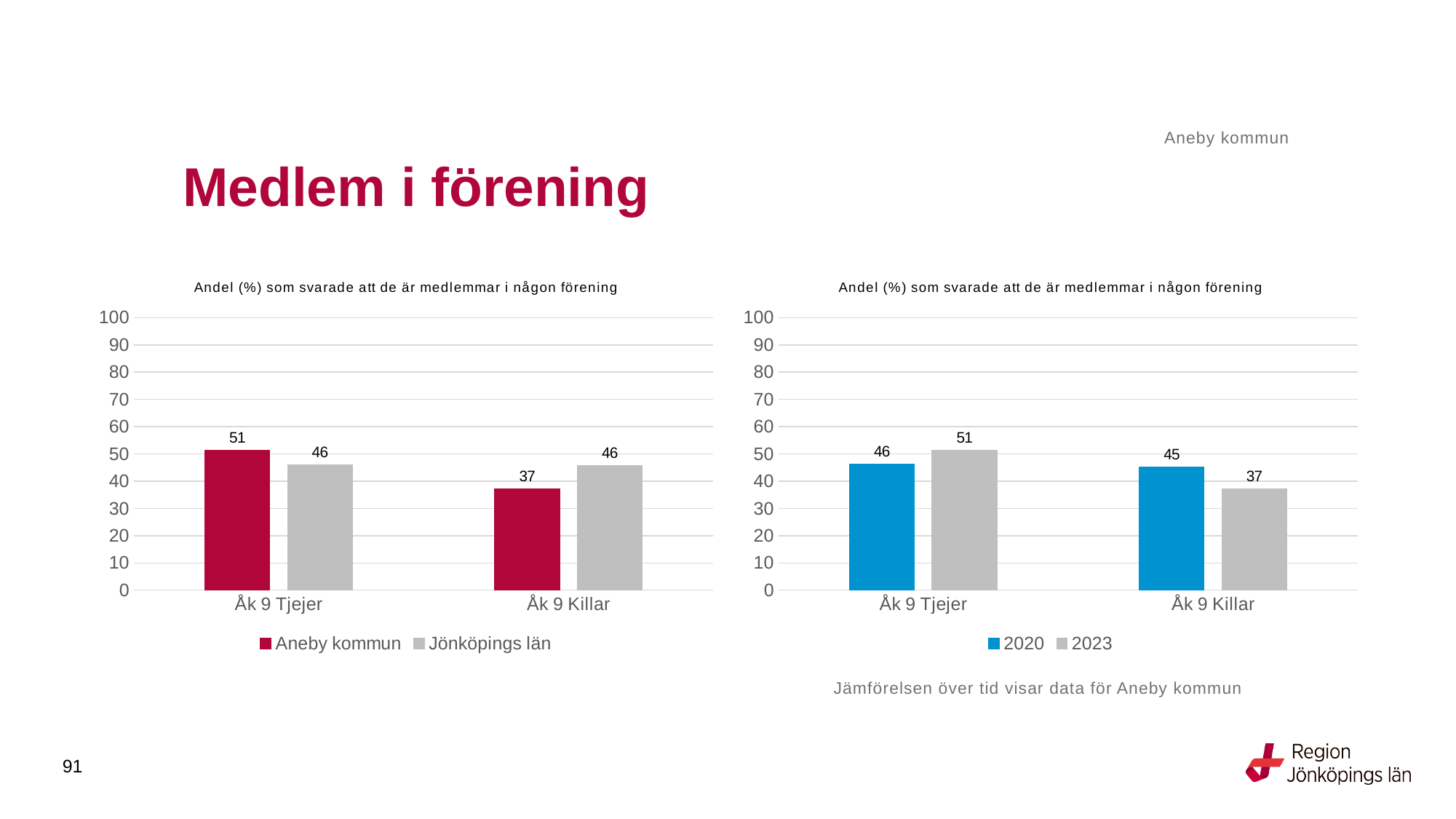
In the left chart, how many series does the legend list? 2 In the left chart, what is the value for Aneby kommun for Åk 9 Tjejer? 51 In the right chart, which is larger for Åk 9 Killar: 2020 or 2023? 2020 How many categories are shown on the x axis of the left chart? 2 In the left chart, what is the difference between Aneby kommun and Jönköpings län for Åk 9 Killar? 9 In the right chart, which bar has the lowest value? 2023 for Åk 9 Killar In the left chart, which is larger for Åk 9 Tjejer: Aneby kommun or Jönköpings län? Aneby kommun In the right chart, what is the value for 2023 for Åk 9 Tjejer? 51 In the left chart, what is the value for Jönköpings län for Åk 9 Killar? 46 What kind of chart is the right chart? Bar chart In the right chart, what is the value for 2020 for Åk 9 Killar? 45 In the right chart, what is the difference between 2020 and 2023 for Åk 9 Killar? 8